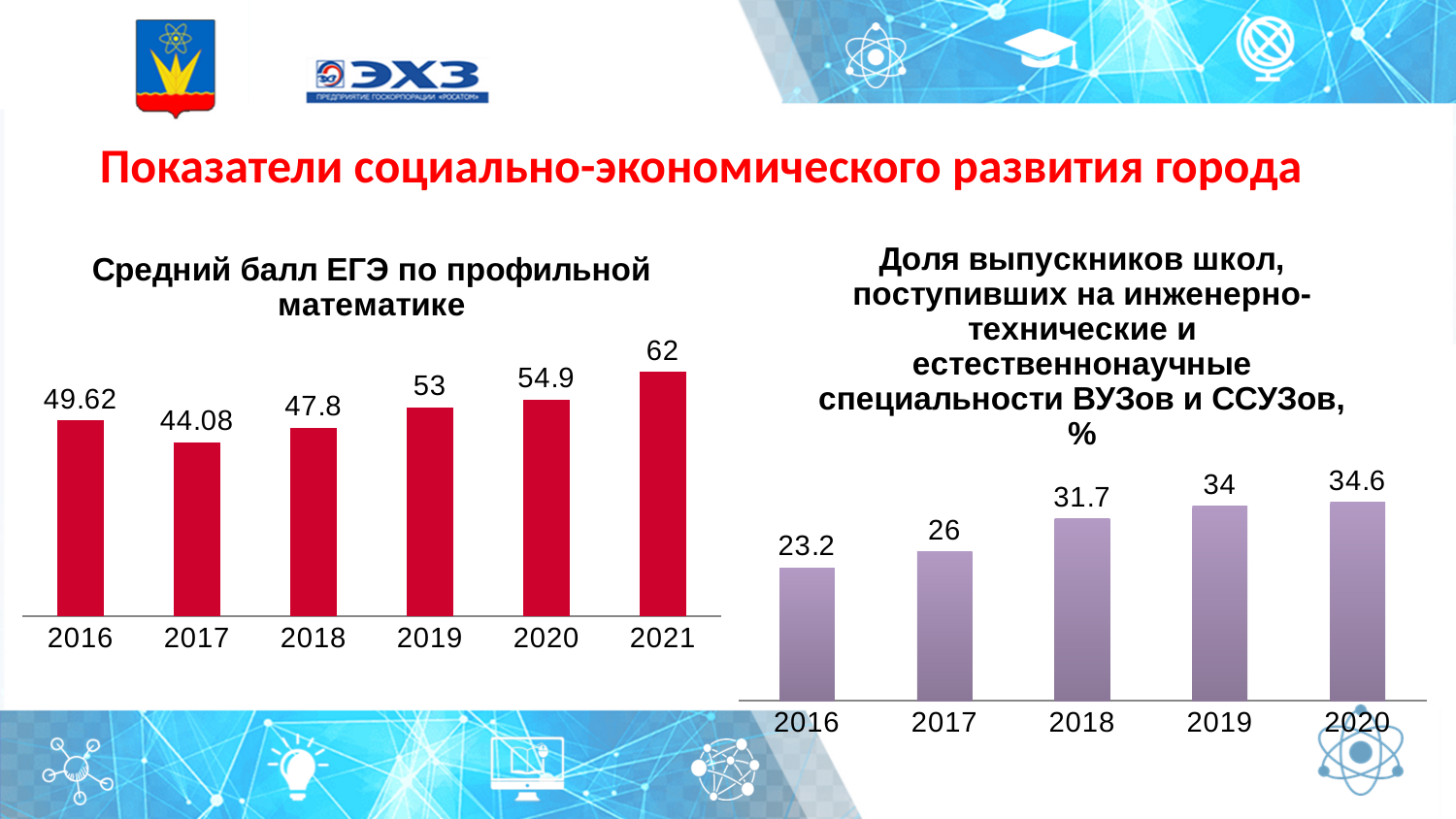
In the right chart (Доля выпускников школ, поступивших на инженерно-технические и естественнонаучные специальности ВУЗов и ССУЗов, %), do the values rise or fall from 2016 to 2020? rise In the right chart (Доля выпускников школ, поступивших на инженерно-технические и естественнонаучные специальности ВУЗов и ССУЗов, %), how many years are shown? 5 In the right chart (Доля выпускников школ, поступивших на инженерно-технические и естественнонаучные специальности ВУЗов и ССУЗов, %), what is the difference between the values for 2018 and 2016? 8.5 In the left chart (Средний балл ЕГЭ по профильной математике), which year has the highest value? 2021 In the left chart (Средний балл ЕГЭ по профильной математике), which is larger, the value for 2016 or the value for 2018? 2016 In the right chart (Доля выпускников школ, поступивших на инженерно-технические и естественнонаучные специальности ВУЗов и ССУЗов, %), what is the value for 2020? 34.6 In the left chart (Средний балл ЕГЭ по профильной математике), what is the value for 2018? 47.8 In the left chart (Средний балл ЕГЭ по профильной математике), how many years are shown? 6 In the left chart (Средний балл ЕГЭ по профильной математике), what is the difference between the values for 2021 and 2020? 7.1 In the left chart (Средний балл ЕГЭ по профильной математике), which year has the lowest value? 2017 What kind of chart is the left chart (Средний балл ЕГЭ по профильной математике)? bar chart In the right chart (Доля выпускников школ, поступивших на инженерно-технические и естественнонаучные специальности ВУЗов и ССУЗов, %), what is the value for 2017? 26